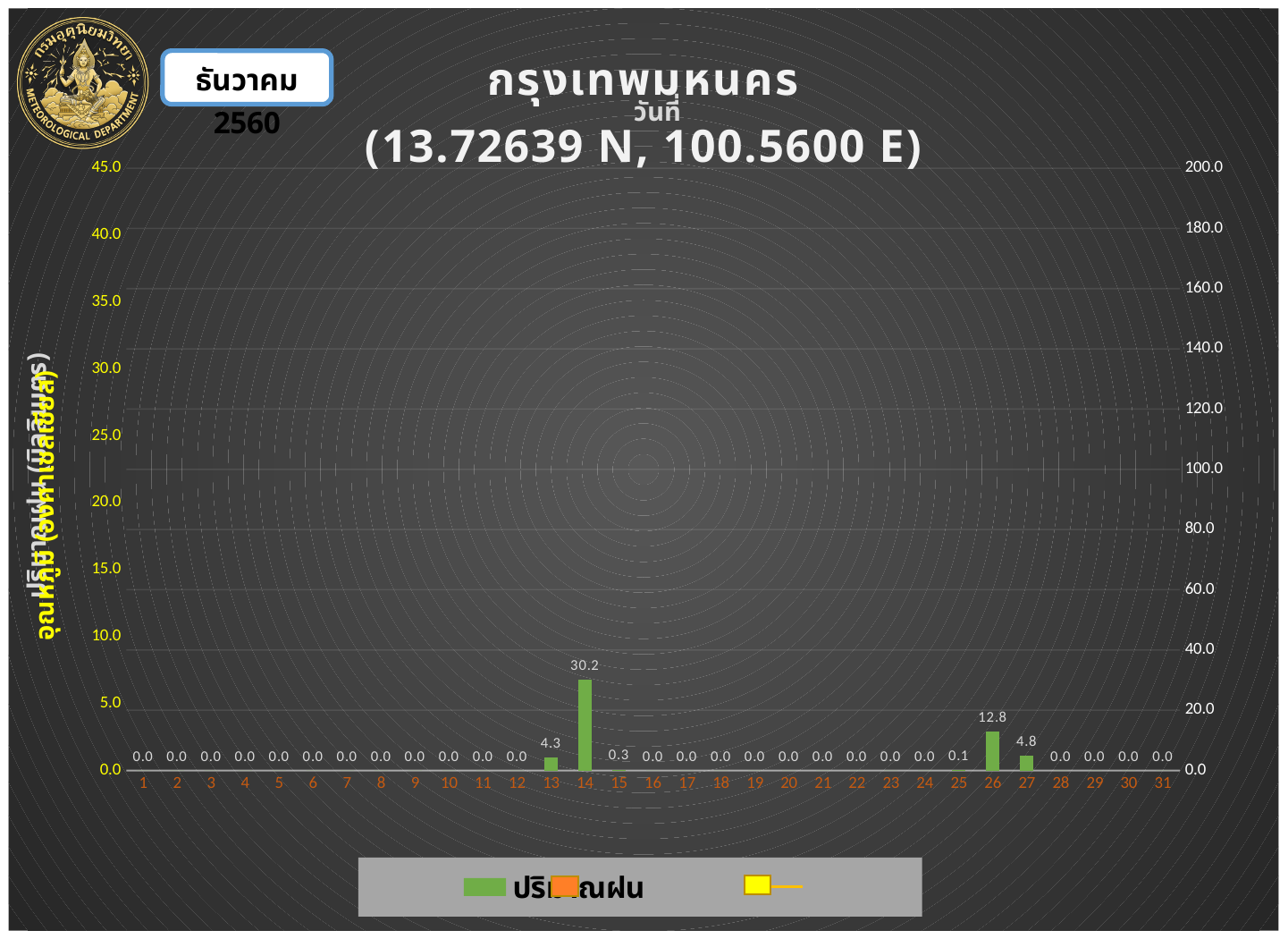
What is the rainfall value shown for day 27? 4.8 Which day has the highest rainfall value? 14 Which is larger, the rainfall value for day 13 or for day 27? day 27 What is the difference between the rainfall values for day 14 and day 26? 17.4 What is the rainfall value shown for day 15? 0.3 How many days are shown on the x axis of the chart? 31 What is the rainfall value shown for day 25? 0.1 What kind of chart is shown on the slide? bar chart What is the rainfall value shown for day 14? 30.2 What coordinates are given in the chart title? 13.72639 N, 100.5600 E What is the rainfall value shown for day 26? 12.8 What is the rainfall value shown for day 13? 4.3